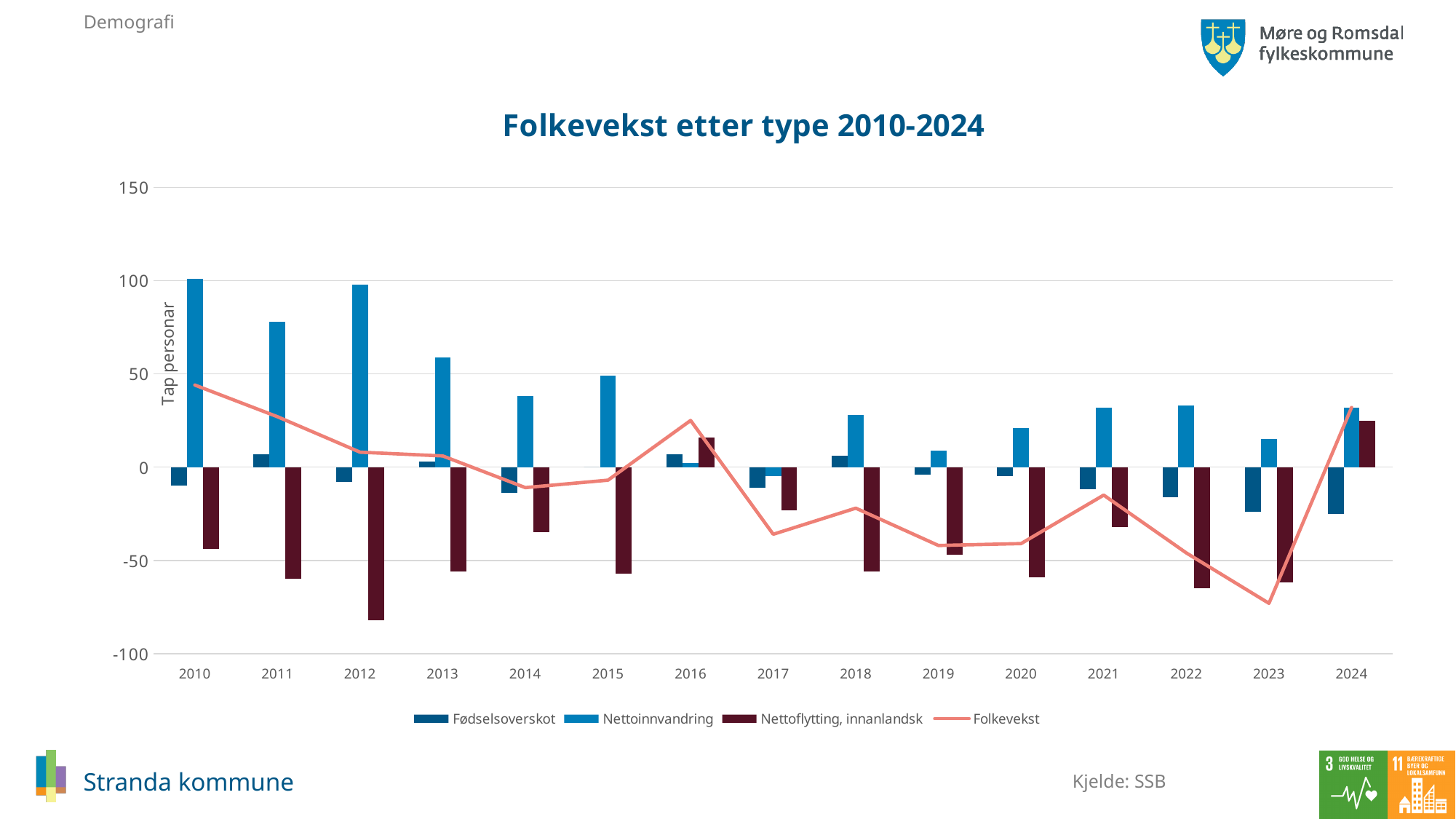
Does Fødselsoverskot rise or fall from 2018 to 2024? Falls Is the value for Nettoinnvandring in 2011 greater or less than 50? greater In which year does the Folkevekst line reach its highest point? 2010 Is the Folkevekst value in 2023 greater or less than -50? less What kind of chart is shown on the slide? A bar chart combined with a line Which is larger, Nettoinnvandring in 2013 or in 2014? 2013 How many series does the legend list? 4 What is the label on the y axis? Tap personar In which year does the Folkevekst line reach its lowest point? 2023 Is the value for Nettoflytting, innanlandsk in 2012 greater or less than -50? less In which year is Nettoflytting, innanlandsk at its lowest (most negative)? 2012 How many years are shown on the x axis? 15